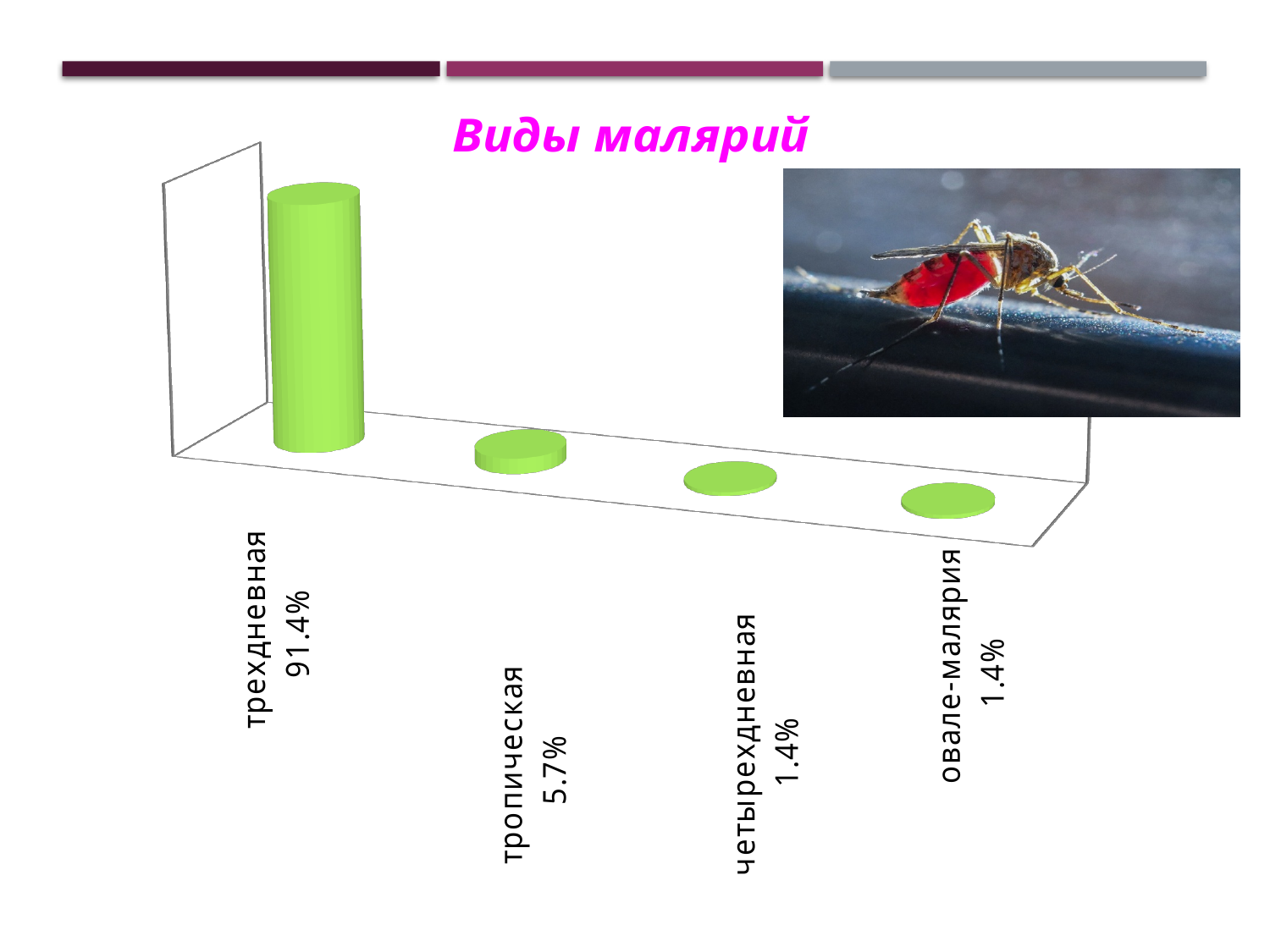
What is the value shown for четырехдневная? 1.4% What kind of chart is shown on the slide? bar chart What is the value shown for тропическая? 5.7% What is the value shown for овале-малярия? 1.4% What is the difference between the values for тропическая and четырехдневная? 4.3% Which is larger, the value for тропическая or the value for овале-малярия? тропическая What is the title of the slide? Виды малярий What is the value shown for трехдневная? 91.4% Which category has the highest value? трехдневная How many categories are shown in the chart? 4 What colour are the bars in the chart? green What is the difference between the values for трехдневная and тропическая? 85.7%